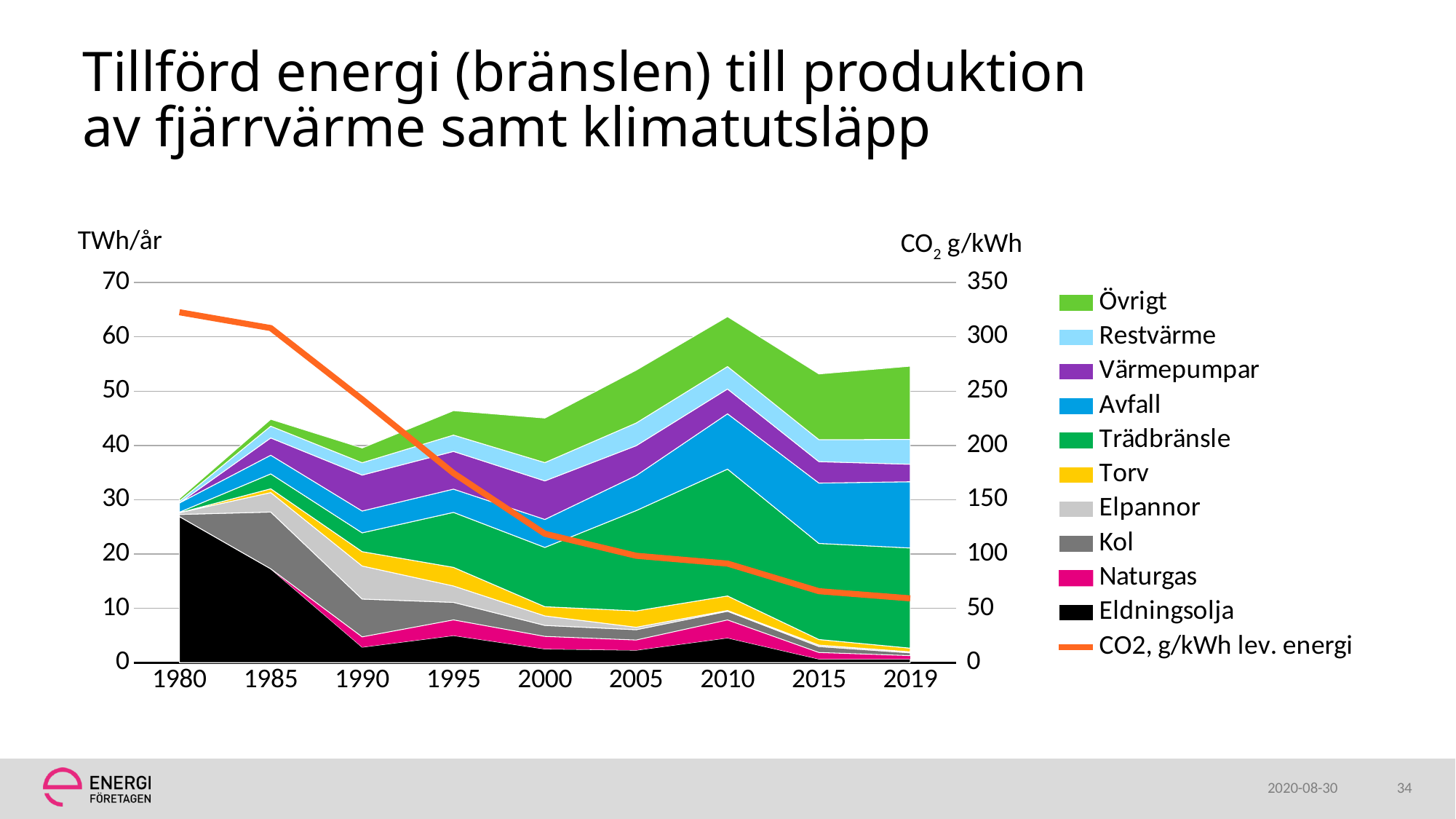
Is the CO2, g/kWh lev. energi value for 2019 greater or less than 100? less Does the CO2, g/kWh lev. energi line rise or fall from 1980 to 2019? Fall Is the CO2, g/kWh lev. energi value for 1980 greater or less than 300? greater What kind of chart is shown on the slide? Stacked area chart with a line In which year is the total supplied energy (top of the stacked area) highest? 2010 How many series does the legend list? 11 In which year is the CO2, g/kWh lev. energi line at its highest? 1980 Which series is shown in black in the legend? Eldningsolja Is the total supplied energy (top of the stacked area) in 2010 greater or less than 60 TWh/år? greater What unit is shown on the left vertical axis? TWh/år How many years are shown along the x axis of the chart? 9 In which year is the CO2, g/kWh lev. energi line at its lowest? 2019